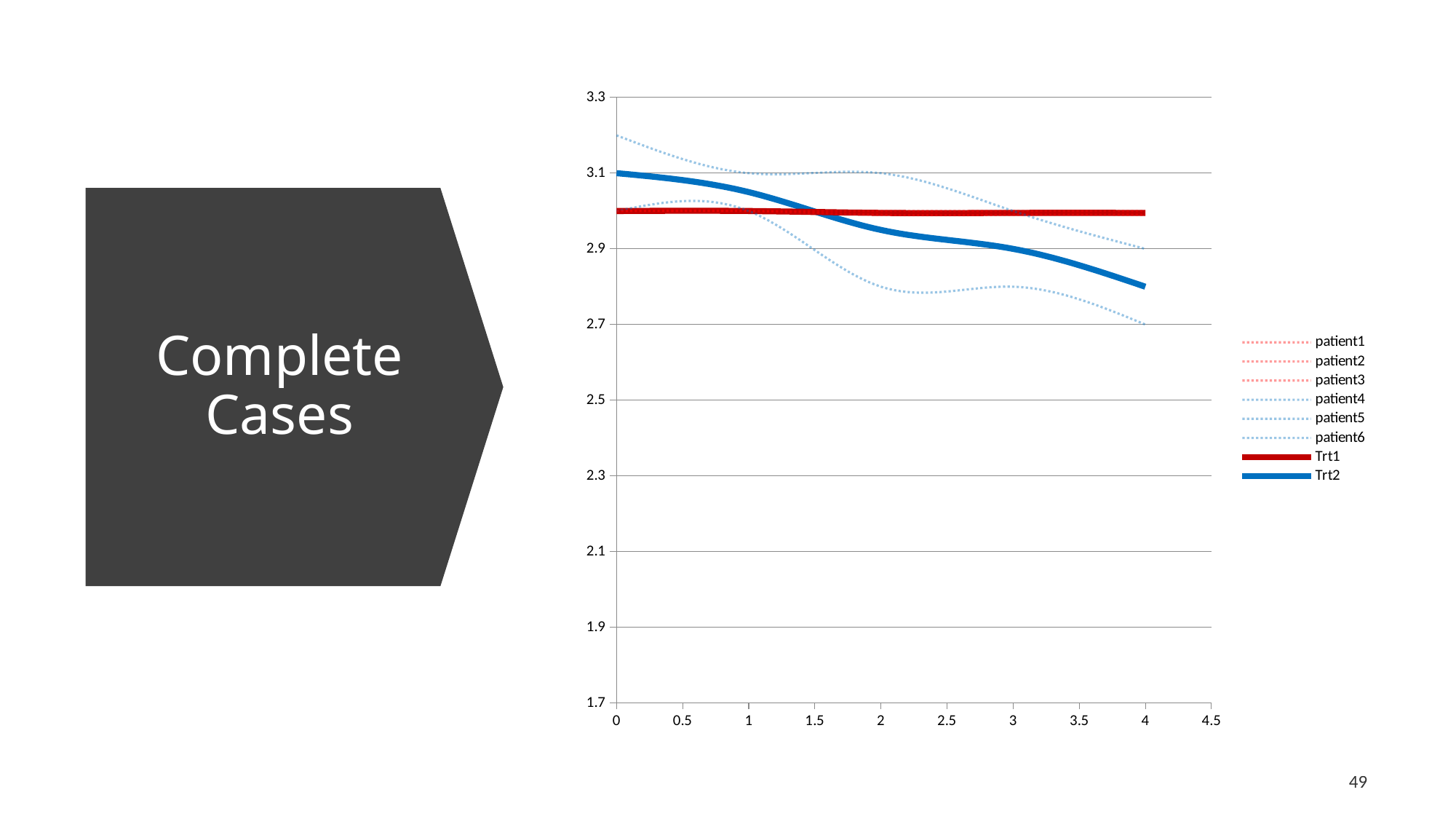
At x = 0, which solid line is higher, Trt1 or Trt2? Trt2 What colour is the Trt1 line in the legend? red Is the value of Trt1 at x = 2 greater or less than 2.9? greater Does the Trt2 line rise or fall as x increases from 0 to 4? fall Is the value of Trt1 at x = 3 greater or less than 3.1? less What is the title text shown on the slide next to the chart? Complete Cases Is the value of Trt2 at x = 4 greater or less than 2.9? less Does the Trt1 line rise, fall, or stay roughly flat across the x axis? stays roughly flat How many series does the legend list? 8 At x = 4, which solid line is higher, Trt1 or Trt2? Trt1 What kind of chart is shown on the slide? line chart What is the value of Trt2 at x = 0? 3.1